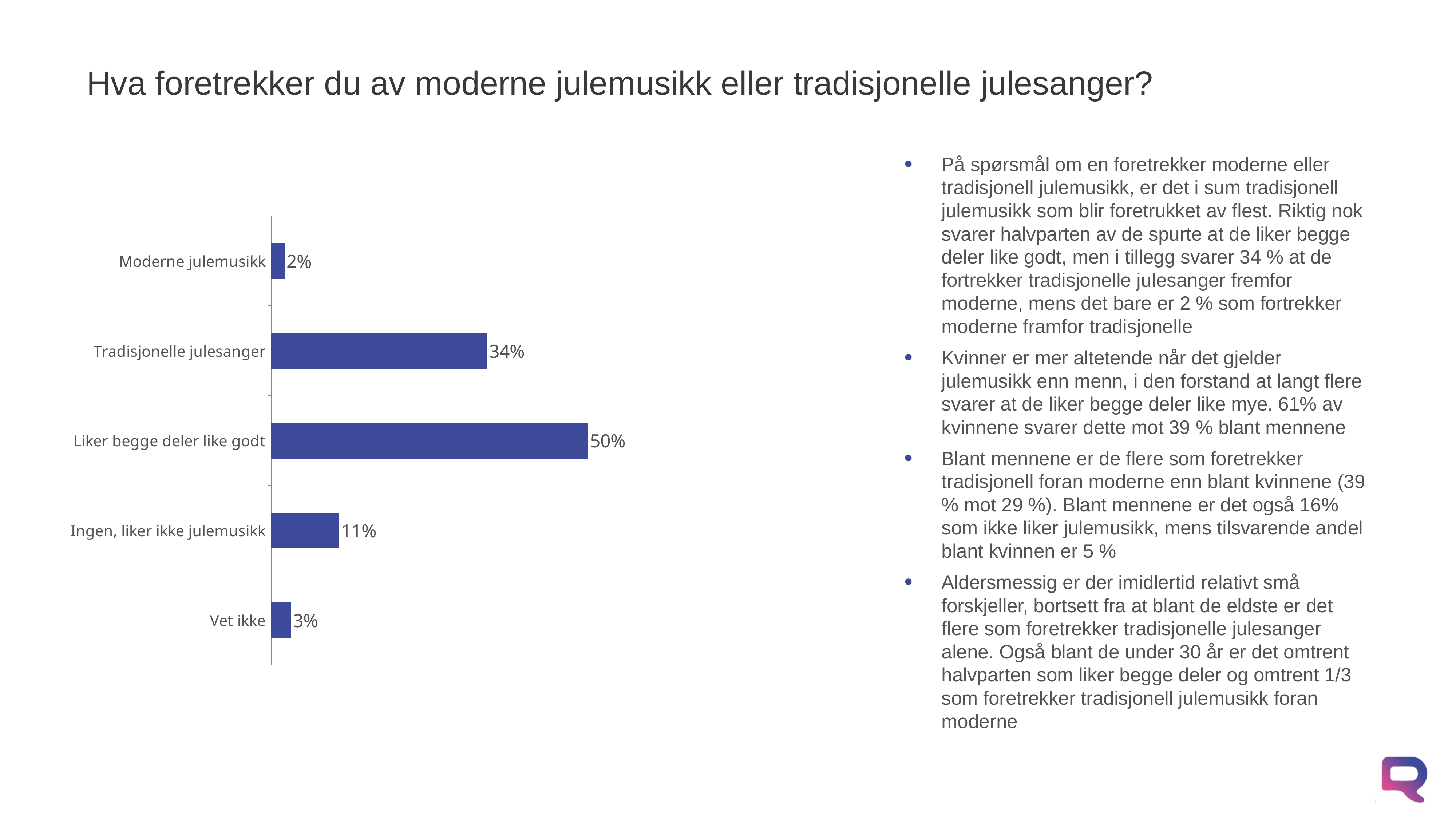
Which category has the lowest value? Moderne julemusikk What kind of chart is shown on the slide? Bar chart What is the value for Liker begge deler like godt? 50% How many categories are shown in the chart? 5 Which category has the highest value? Liker begge deler like godt What is the title of the slide? Hva foretrekker du av moderne julemusikk eller tradisjonelle julesanger? What is the value for Moderne julemusikk? 2% What is the value for Vet ikke? 3% What is the value for Ingen, liker ikke julemusikk? 11% Which is larger, Ingen, liker ikke julemusikk or Vet ikke? Ingen, liker ikke julemusikk What is the difference between Liker begge deler like godt and Tradisjonelle julesanger? 16% What is the value for Tradisjonelle julesanger? 34%